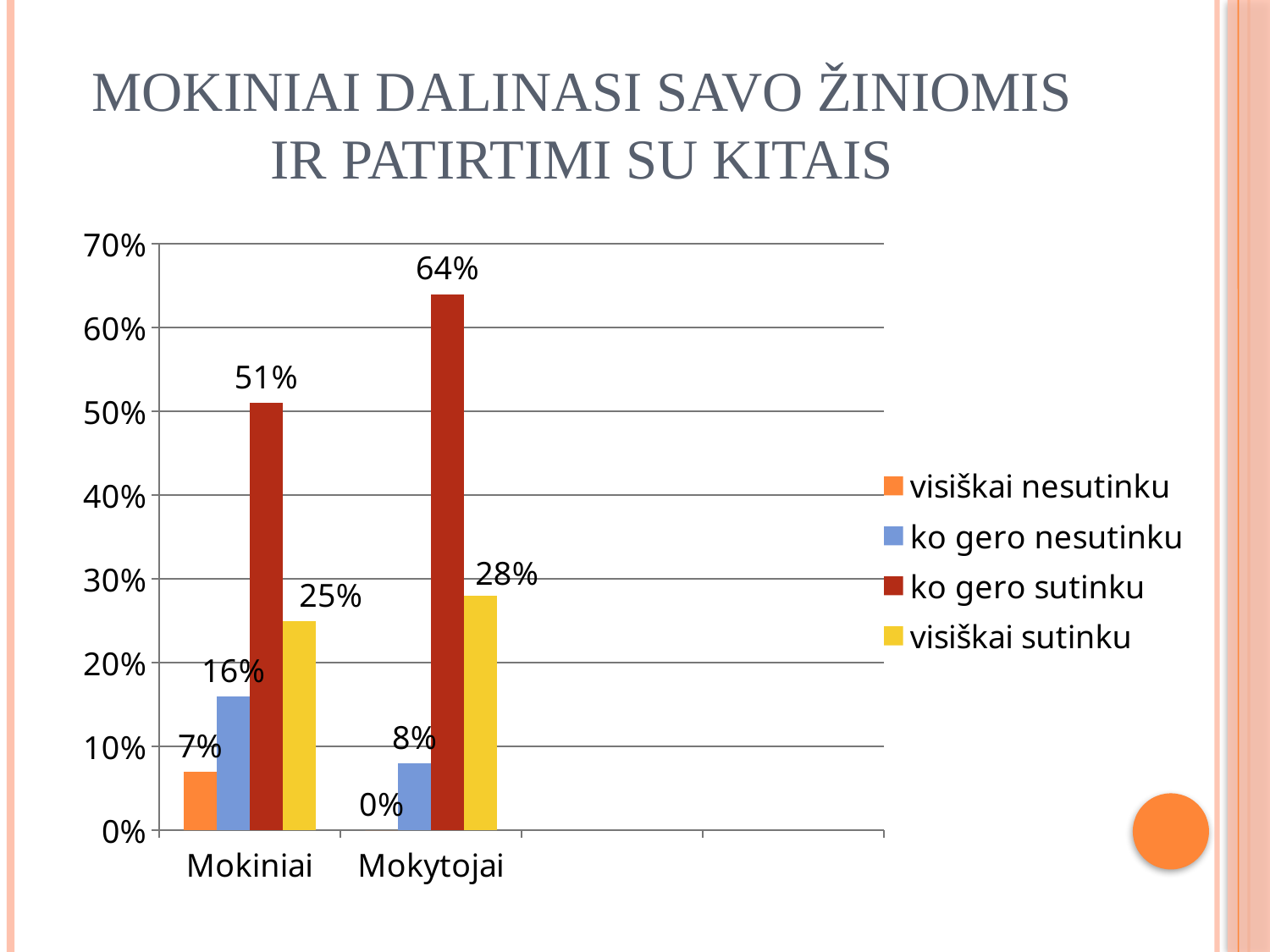
What is the value for "visiškai sutinku" in the Mokytojai category? 28% What is the value for "ko gero nesutinku" in the Mokiniai category? 16% What is the value for "visiškai nesutinku" in the Mokiniai category? 7% How many categories are shown on the x axis? 2 What colour represents the "ko gero sutinku" series? Dark red Which series has the highest value in the Mokiniai category? ko gero sutinku What kind of chart is shown on the slide? Bar chart Which series has the lowest value in the Mokytojai category? visiškai nesutinku What is the value for "ko gero sutinku" in the Mokytojai category? 64% Which is larger: "visiškai sutinku" for Mokiniai or for Mokytojai? Mokytojai What is the difference between the "ko gero sutinku" values for Mokytojai and Mokiniai? 13% How many series does the legend list? 4